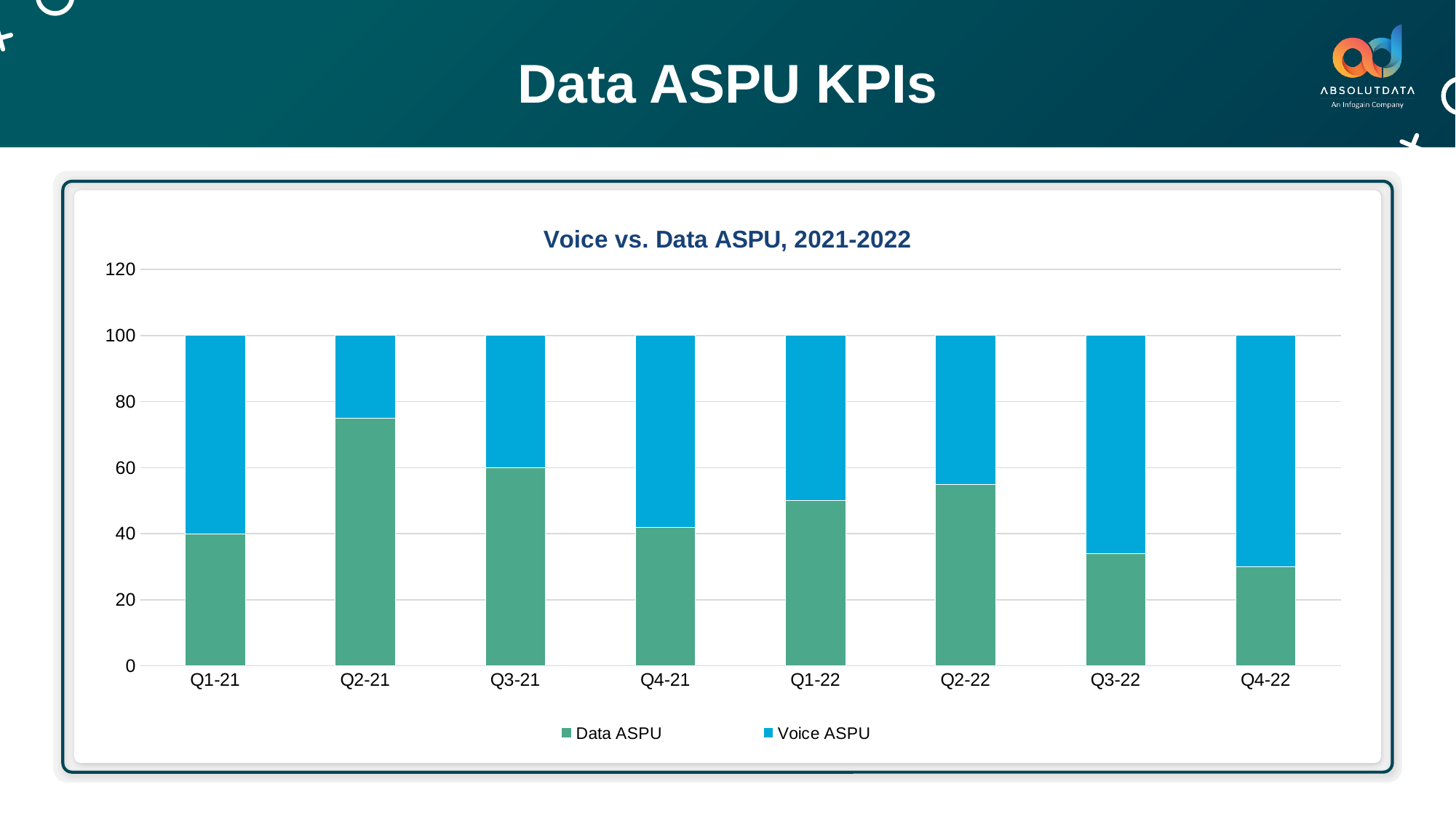
Which quarter has the lowest Voice ASPU? Q2-21 What is the Data ASPU value for Q1-21? 40 Which is larger, the Data ASPU for Q2-22 or the Data ASPU for Q3-22? Q2-22 Is the Data ASPU value for Q4-22 greater or less than 40? less Which quarter has the highest Data ASPU? Q2-21 What is the total height of the stacked bar for Q4-22? 100 How many series does the legend list? 2 How many quarters are shown on the x axis? 8 Is the Data ASPU value for Q2-21 greater or less than 60? greater What is the title of the chart? Voice vs. Data ASPU, 2021-2022 What kind of chart is shown on the slide? Stacked bar chart What is the Data ASPU value for Q3-21? 60